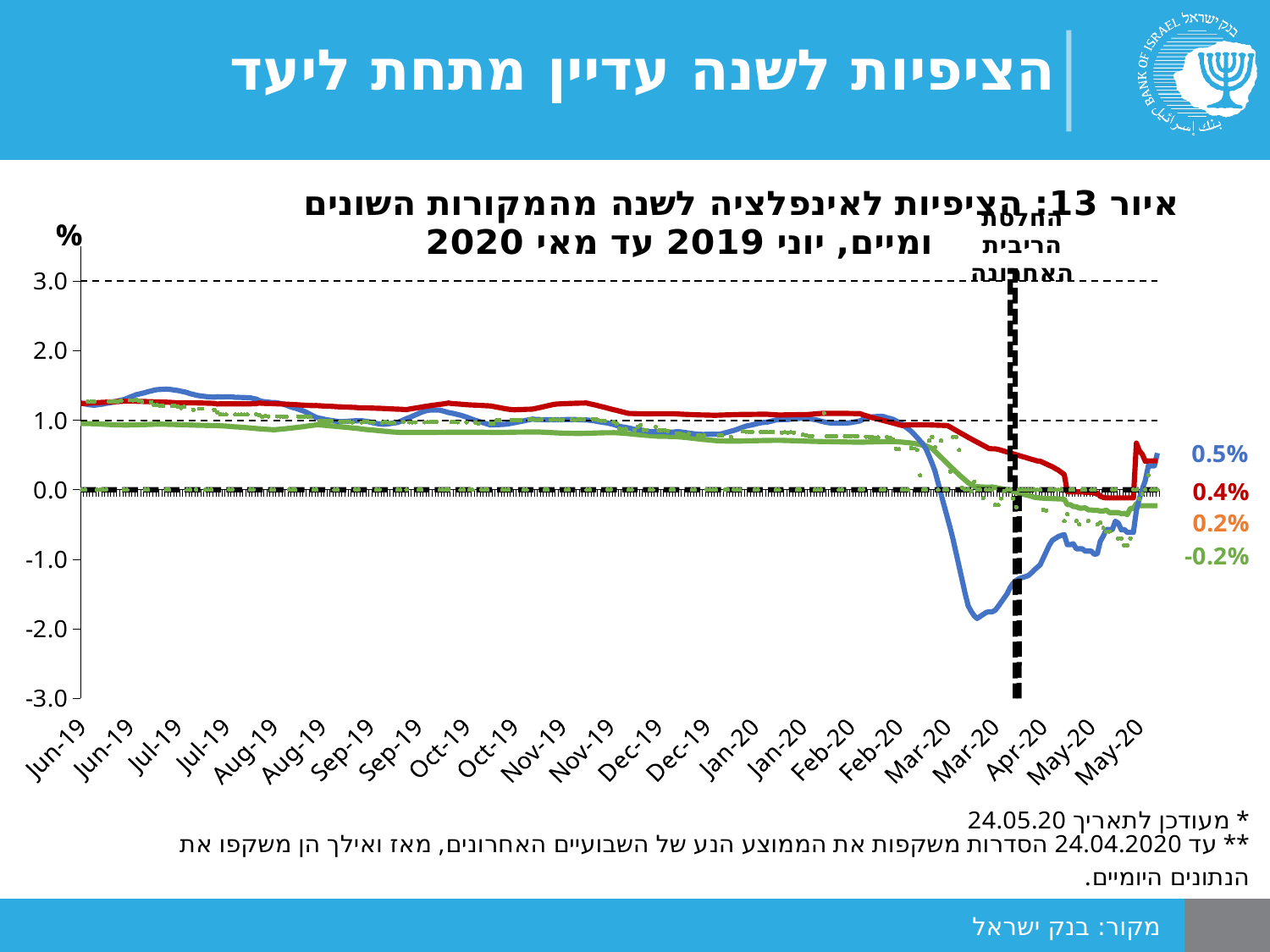
What is the final value labelled for the red line at the right edge of the chart? 0.4% What is the final value labelled for the orange dotted line at the right edge of the chart? 0.2% What is the final value labelled for the green line at the right edge of the chart? -0.2% What is the final value labelled for the blue line at the right edge of the chart? 0.5% Which line has the lowest labelled end value? the green line (-0.2%) What is the difference between the labelled end values of the blue line (0.5%) and the green line (-0.2%)? 0.7 percentage points What is the highest value shown on the vertical axis? 3.0 What kind of chart is shown on the slide? line chart Is the value of the blue line in Jul-19 greater or less than 1.0? greater Does the blue line rise or fall between Feb-20 and Mar-20? fall Is the lowest point of the blue line in Mar-20 greater or less than -1.0? less Which line has the highest labelled end value? the blue line (0.5%)